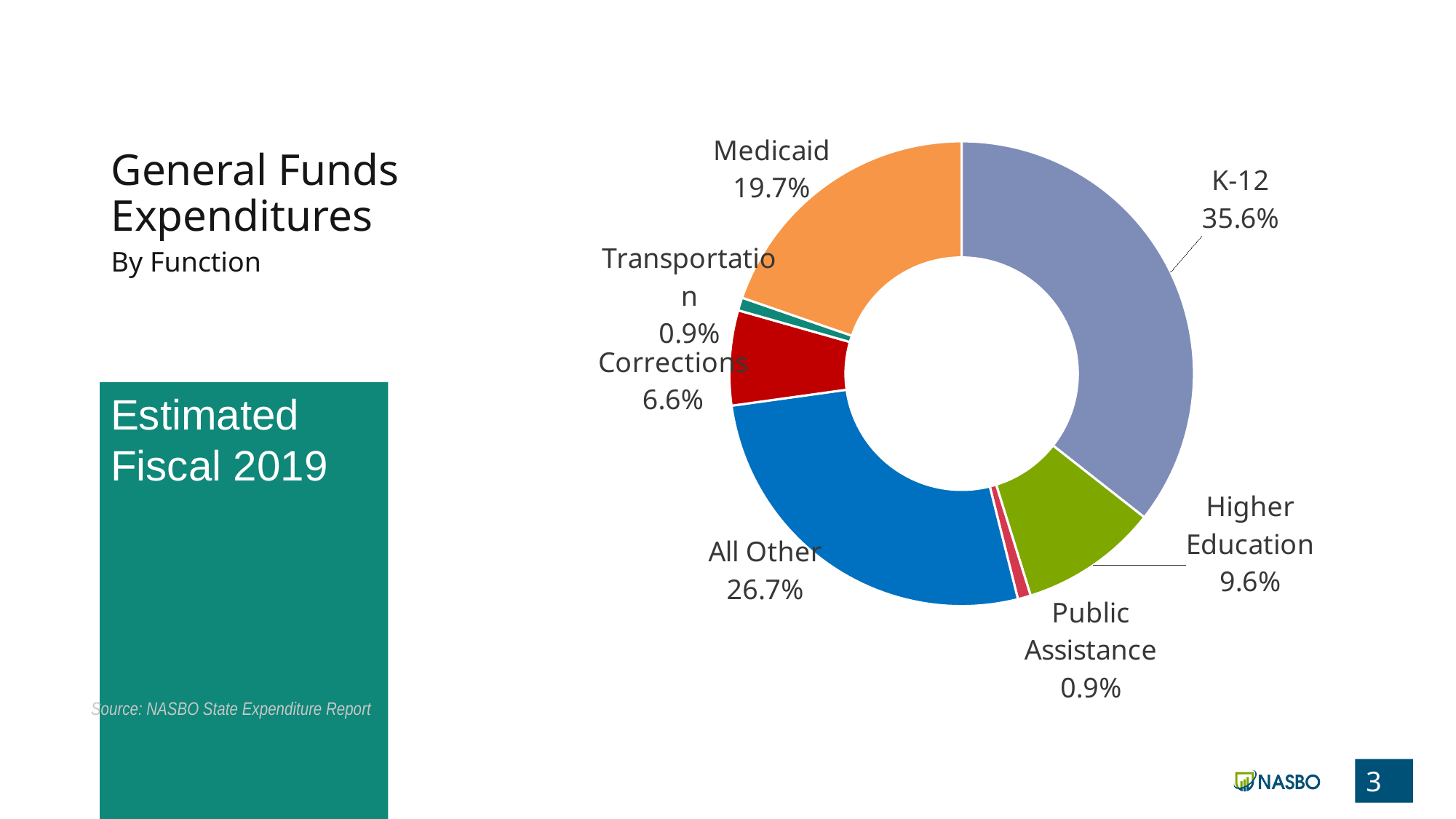
Which function has the largest share of general fund expenditures? K-12 Which is larger, the share for Higher Education or the share for Corrections? Higher Education What percentage is labelled for Corrections? 6.6% How many functions are shown in the chart? 7 Which two functions each account for 0.9% of expenditures? Transportation and Public Assistance What is the difference in percentage points between K-12 and Medicaid? 15.9 What is the combined share of K-12 and Higher Education? 45.2% What share of general fund expenditures goes to K-12? 35.6% What kind of chart is used on this slide? Donut (pie) chart What is the value for Higher Education? 9.6% Which function has the largest share after K-12? All Other What percentage is shown for Medicaid? 19.7%